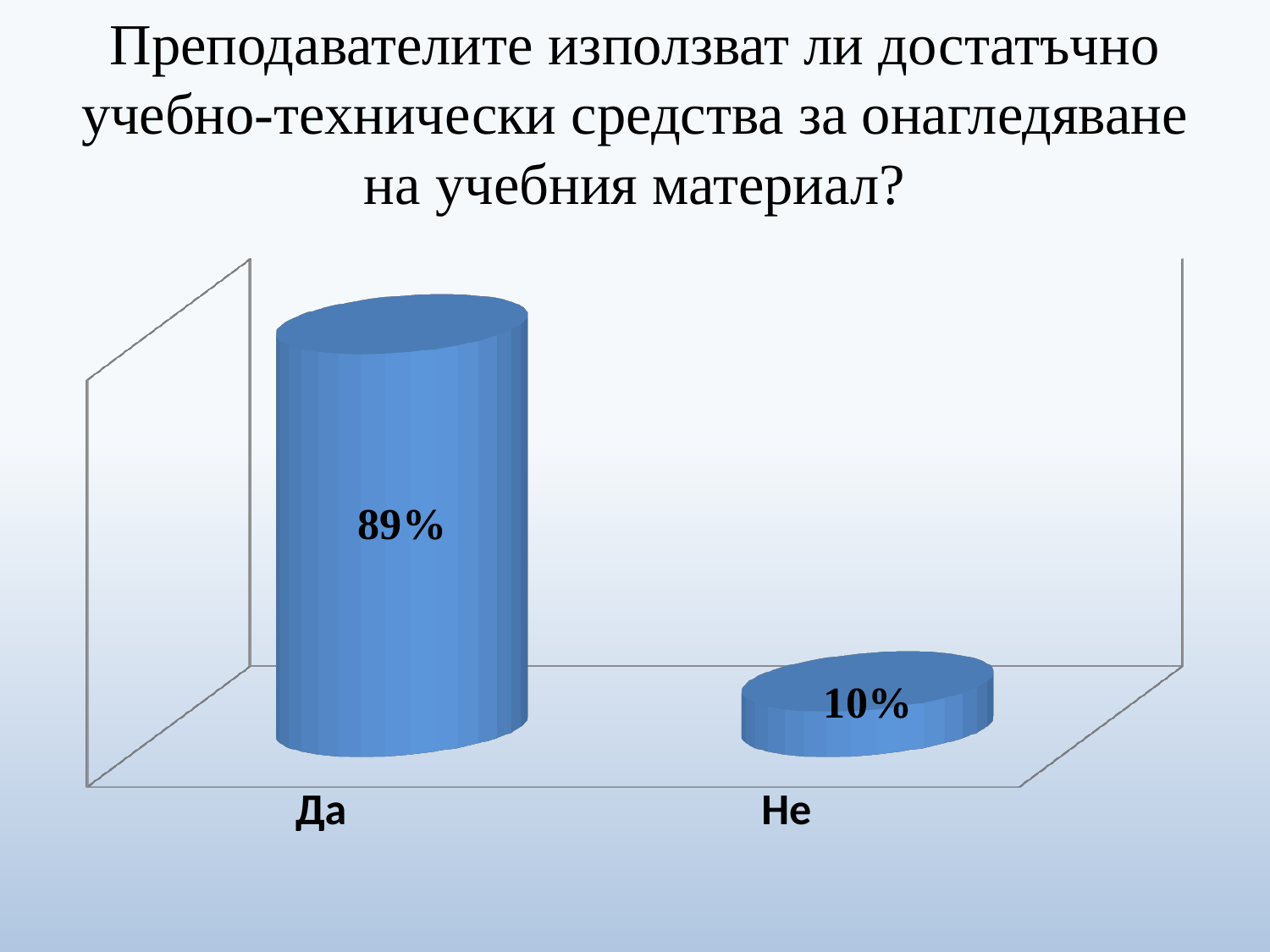
Which is larger, the value for "Да" or the value for "Не"? Да Which category has the lowest value? Не What is the value for "Да"? 89% What is the difference between the values for "Да" and "Не"? 79% What is the value for "Не"? 10% What colour are the bars in the chart? Blue What kind of chart is shown on the slide? Bar chart What is the title of the slide above the chart? Преподавателите използват ли достатъчно учебно-технически средства за онагледяване на учебния материал? How many categories are shown in the chart? 2 Which category has the highest value? Да Do the values rise or fall from left to right along the x axis? Fall